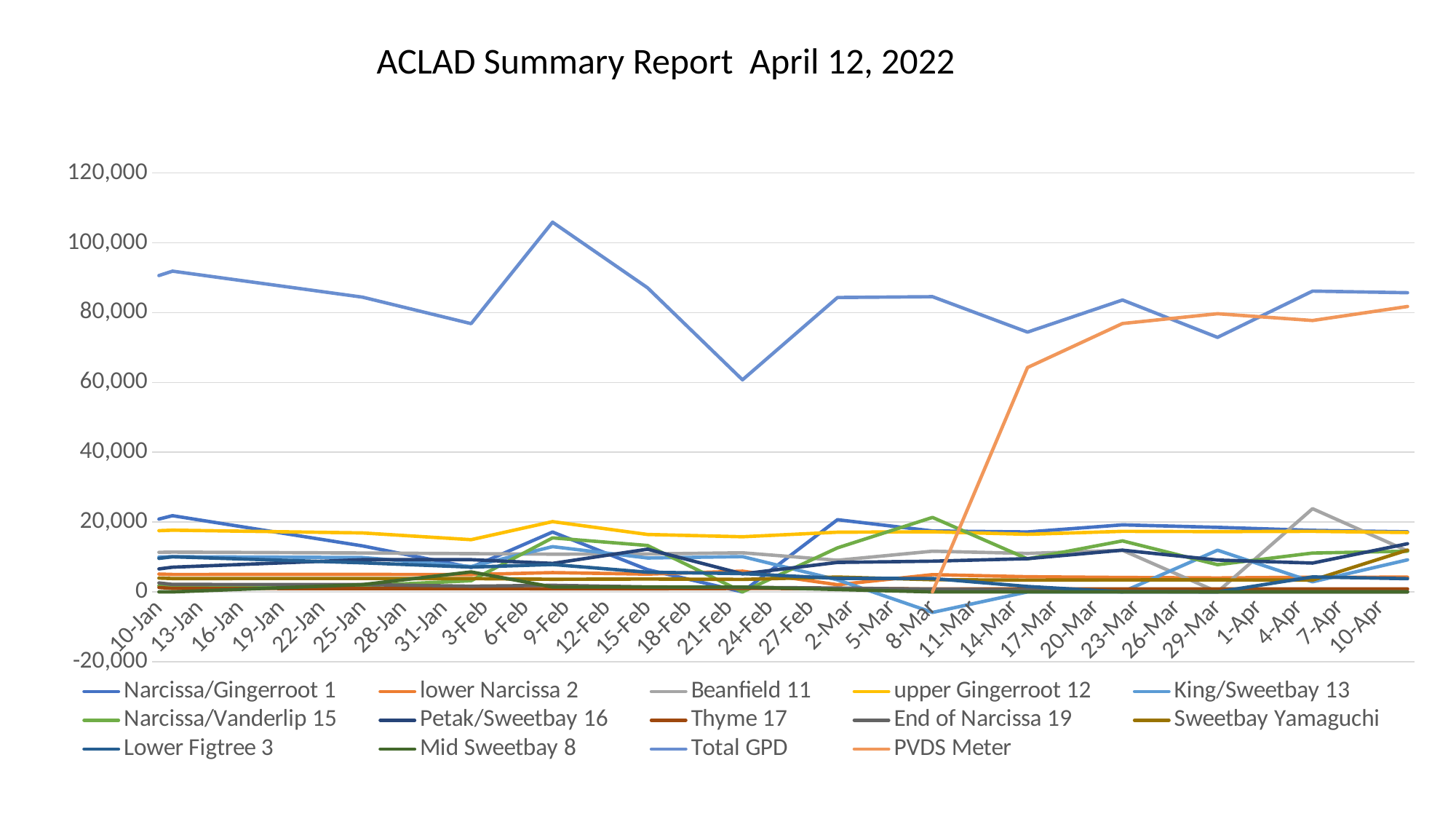
On which date does the Total GPD series reach its highest value? 9-Feb Does the PVDS Meter series rise or fall between 8-Mar and 17-Mar? rise Is the value for Total GPD on 21-Feb greater or less than 80,000? less On which date does the Total GPD series reach its lowest value? 21-Feb What is the title of the chart? ACLAD Summary Report April 12, 2022 How many dates are shown along the x axis? 31 What kind of chart is shown on the slide? line chart How many series does the legend list? 14 Is the value for Total GPD on 9-Feb greater or less than 100,000? greater Is the value for PVDS Meter on 17-Mar greater or less than 60,000? greater On 29-Mar, which is larger: Total GPD or PVDS Meter? PVDS Meter On 17-Mar, which is larger: Total GPD or PVDS Meter? Total GPD